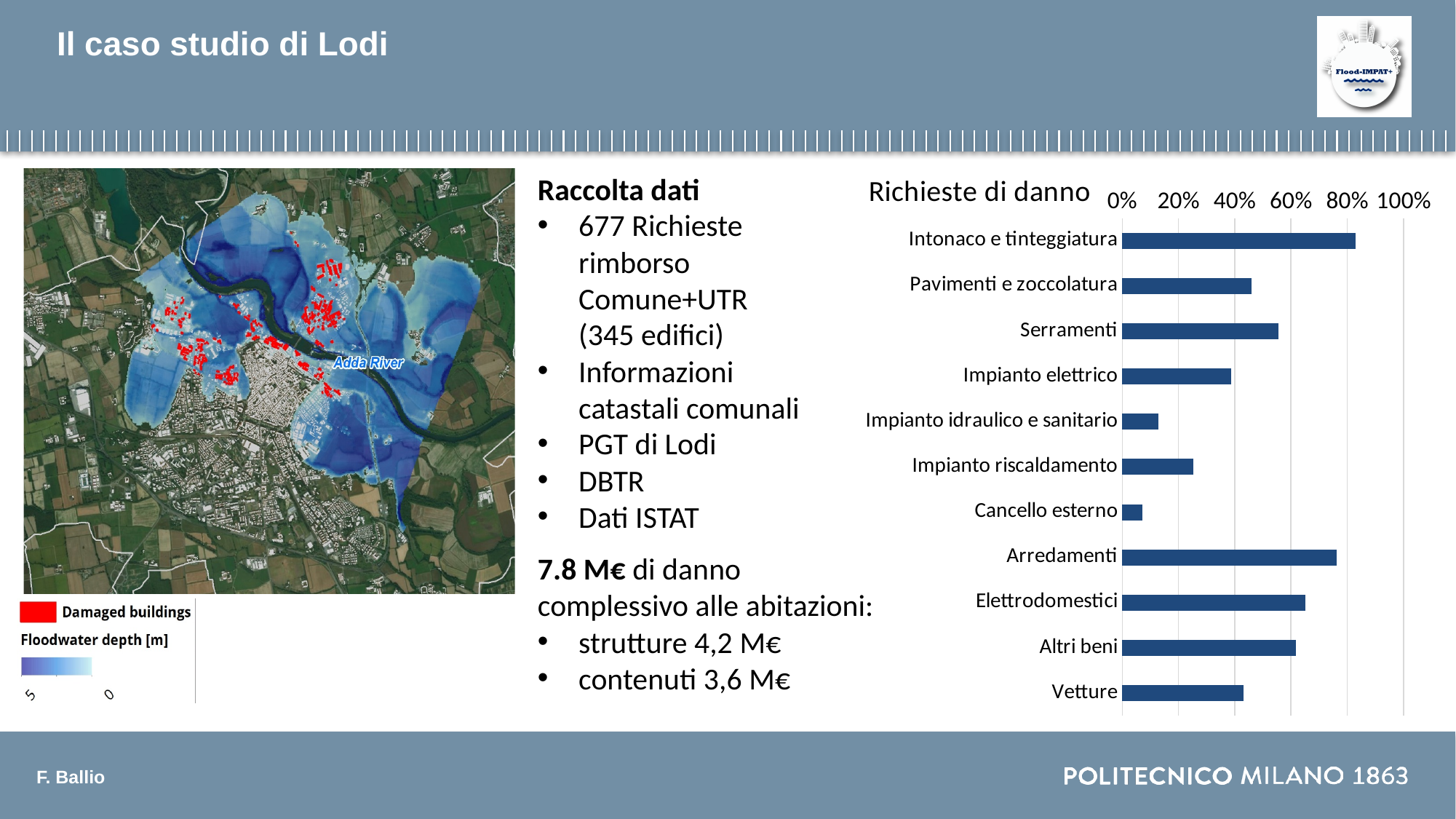
Is the value for Intonaco e tinteggiatura greater or less than 80%? greater Which has a larger value, Serramenti or Pavimenti e zoccolatura? Serramenti Which category has the lowest value in the chart? Cancello esterno Is the value for Cancello esterno greater or less than 20%? less How many categories are plotted in the chart? 11 Which has a larger value, Arredamenti or Vetture? Arredamenti Is the value for Impianto idraulico e sanitario greater or less than 20%? less Which category has the highest value in the chart? Intonaco e tinteggiatura What is the title of the chart on the slide? Richieste di danno What kind of chart is shown on the slide? bar chart